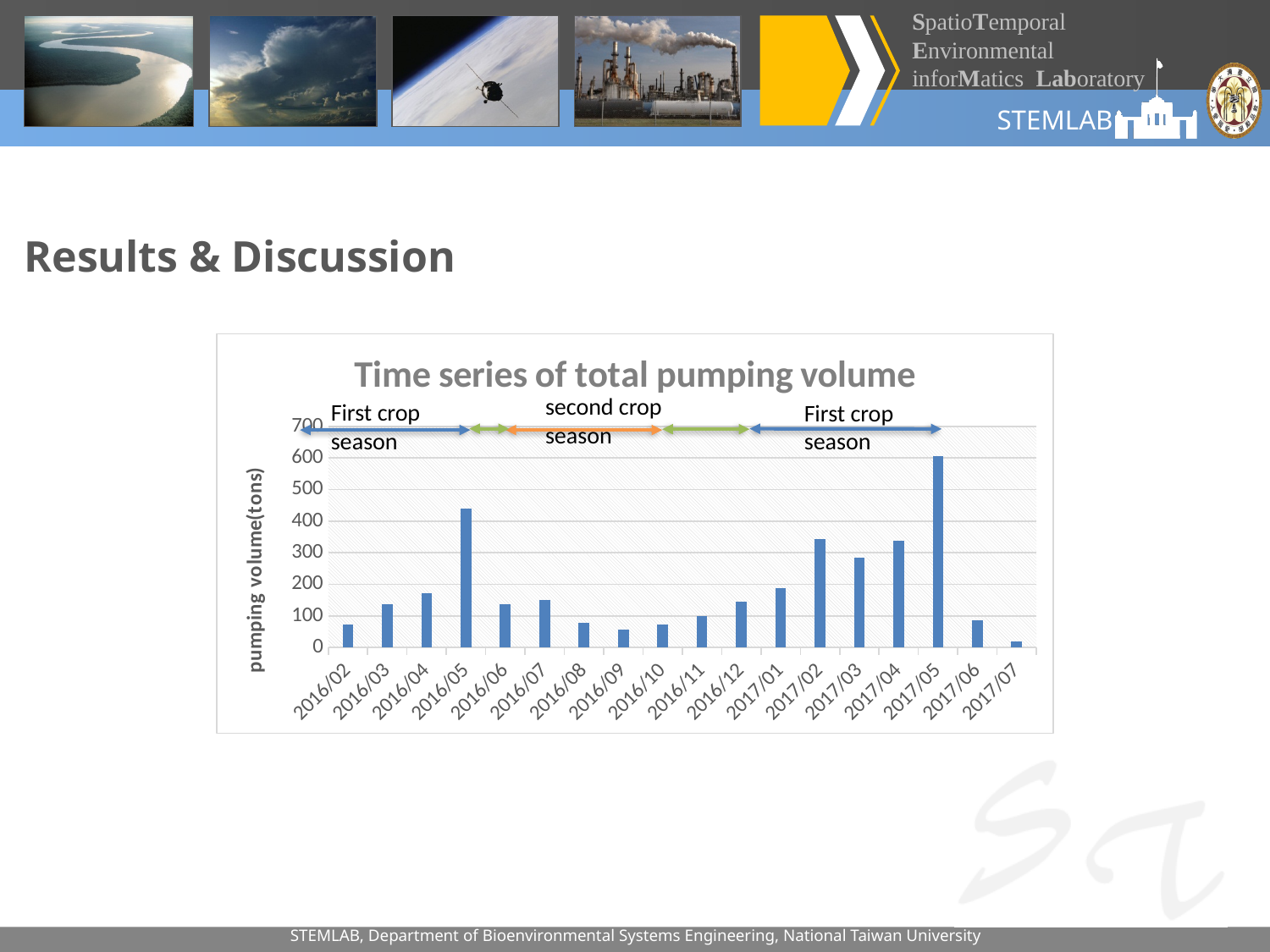
What is the title of the chart? Time series of total pumping volume Which month has the highest total pumping volume? 2017/05 Is the pumping volume for 2017/02 greater or less than 300? greater Which month has a larger pumping volume, 2016/05 or 2017/02? 2016/05 What kind of chart is shown on the slide? bar chart How many months are plotted along the x axis? 18 Is the pumping volume for 2017/05 greater or less than 500? greater What is the label of the vertical axis? pumping volume(tons) Is the pumping volume for 2016/05 greater or less than 400? greater Which month has the lowest total pumping volume? 2017/07 Does the pumping volume rise or fall from 2016/05 to 2016/09? fall